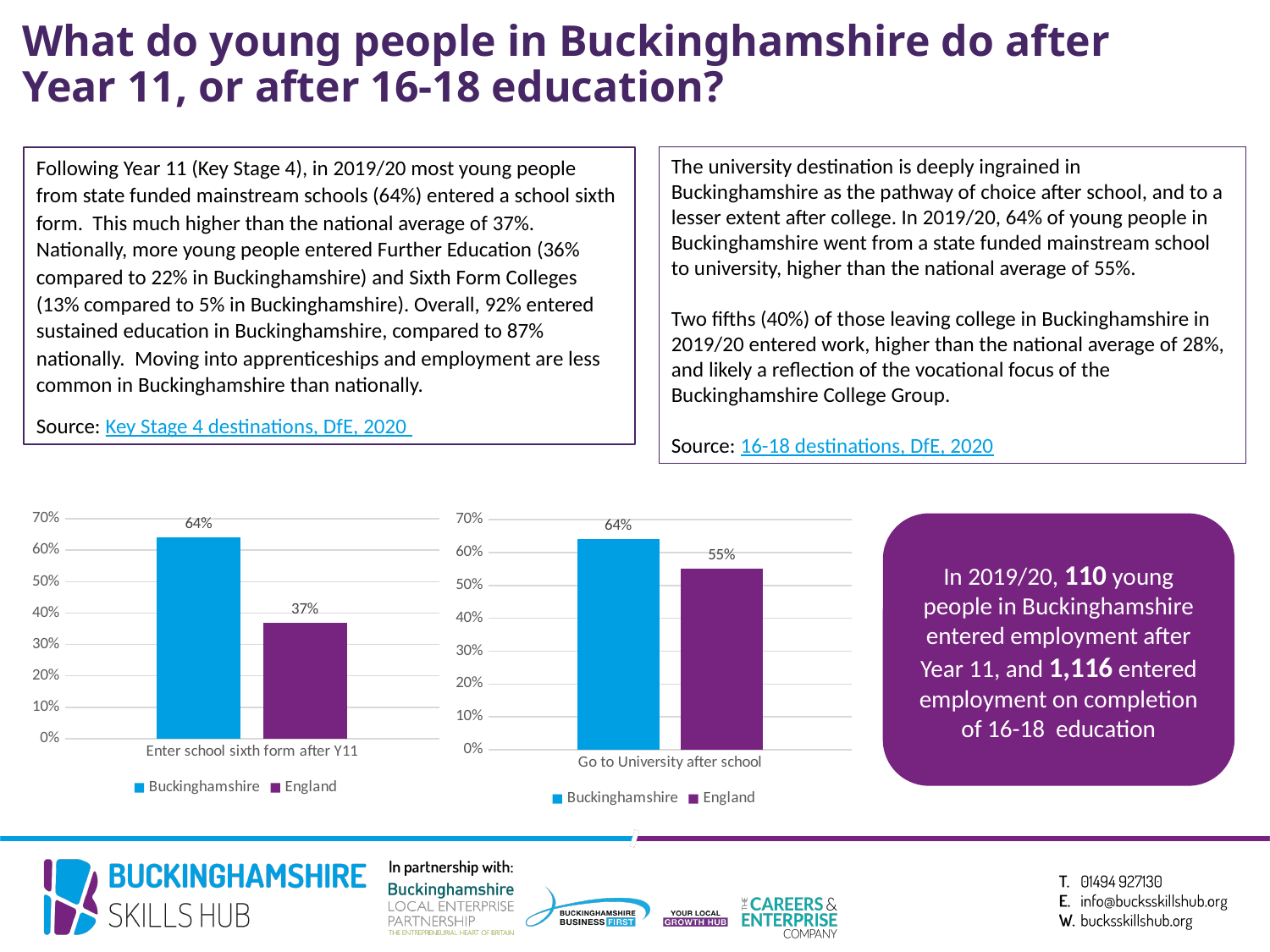
In the left chart (Enter school sixth form after Y11), what is the value for England? 37% In the left chart (Enter school sixth form after Y11), what is the difference between the Buckinghamshire and England values? 27% In the right chart (Go to University after school), what is the value for England? 55% What colour represents England in the right chart's legend? Purple In the right chart (Go to University after school), what is the value for Buckinghamshire? 64% In the left chart (Enter school sixth form after Y11), which series has the higher value? Buckinghamshire In the left chart, is the value for England greater or less than 40%? less What kind of chart is the right chart (Go to University after school)? Bar chart In the right chart (Go to University after school), what is the difference between the Buckinghamshire and England values? 9% In the left chart (Enter school sixth form after Y11), what is the value for Buckinghamshire? 64% How many series does the legend of the left chart list? 2 In the right chart (Go to University after school), which series has the lower value? England